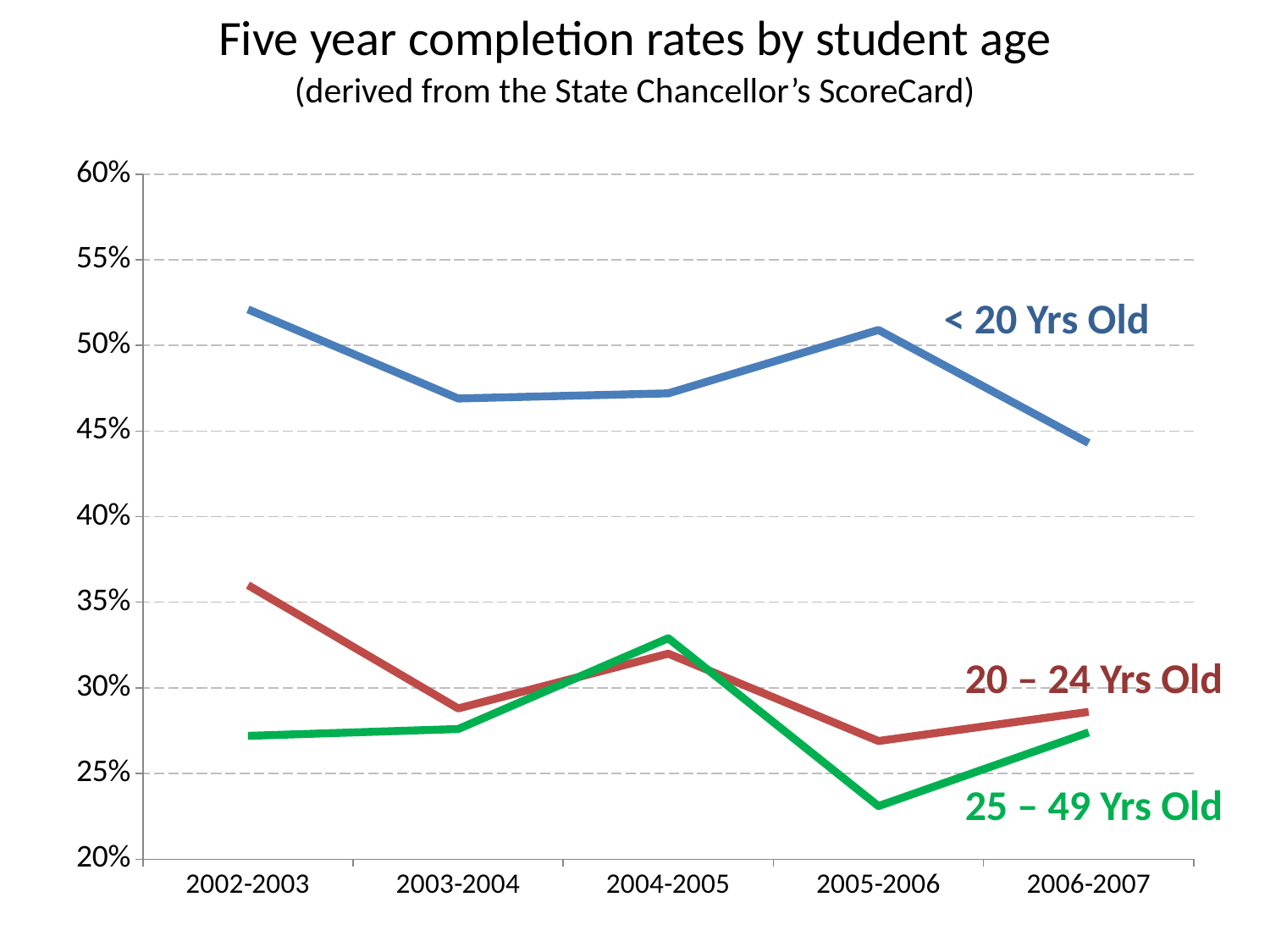
In which year is the completion rate for < 20 Yrs Old lowest? 2006-2007 In 2005-2006, which has the higher completion rate: 20 – 24 Yrs Old or 25 – 49 Yrs Old? 20 – 24 Yrs Old What kind of chart is shown on the slide? line chart In which year is the completion rate for 25 – 49 Yrs Old highest? 2004-2005 What colour is the line for < 20 Yrs Old? blue Does the completion rate for 25 – 49 Yrs Old rise or fall from 2004-2005 to 2005-2006? fall How many age-group series are plotted on the chart? 3 Is the value for 25 – 49 Yrs Old in 2004-2005 greater or less than 30%? greater How many academic years are plotted along the x axis? 5 In which year is the completion rate for 25 – 49 Yrs Old lowest? 2005-2006 In which year is the completion rate for 20 – 24 Yrs Old highest? 2002-2003 Is the value for < 20 Yrs Old in 2006-2007 greater or less than 45%? less